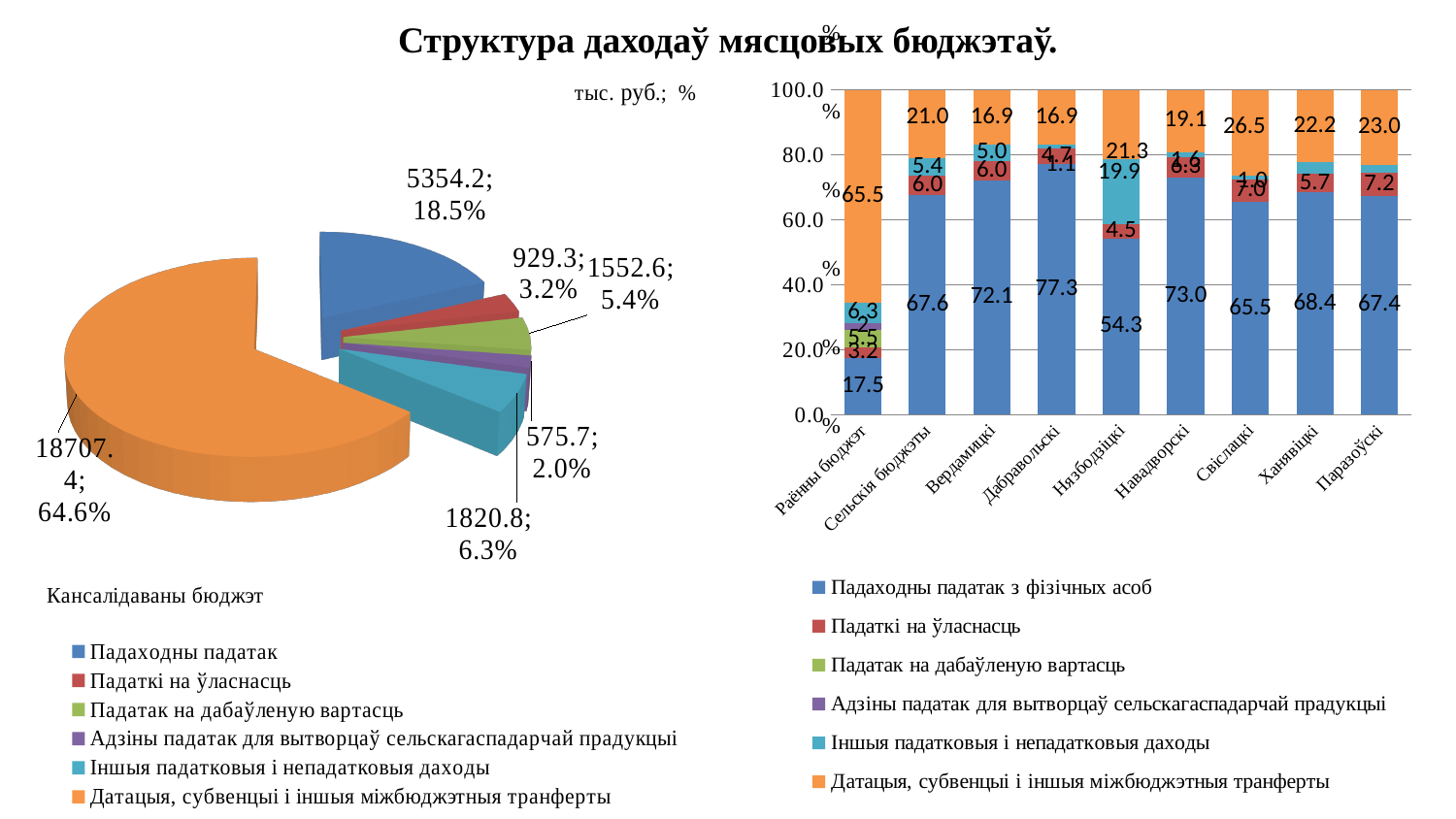
On the pie chart (left), what share does the slice labelled 1552.6 have? 5.4% On the pie chart (left), which slice is the smallest? Адзіны падатак для вытворцаў сельскагаспадарчай прадукцыі (575.7; 2.0%) What kind of chart is the chart on the left of the slide? Pie chart On the pie chart (left), how many entries does the legend list? 6 On the pie chart (left), what value is shown for the orange slice, Датацыі, субвенцыі і іншыя міжбюджэтныя трансферты? 18707.4; 64.6% On the stacked bar chart (right), how many categories are shown on the x axis? 9 On the stacked bar chart (right), what is the value of the orange segment (Датацыі, субвенцыі і іншыя міжбюджэтныя трансферты) for Раённы бюджэт? 65.5 On the stacked bar chart (right), what is the difference between the blue segment values for Дабравольскі and Нязбодзіцкі? 23.0 On the stacked bar chart (right), what is the value of the blue segment (Падаходны падатак з фізічных асоб) for Дабравольскі? 77.3 On the pie chart (left), what value is shown for the blue slice, Падаходны падатак? 5354.2; 18.5% On the stacked bar chart (right), which category has the lowest value for the blue segment (Падаходны падатак з фізічных асоб)? Раённы бюджэт On the stacked bar chart (right), is the orange segment value for Свіслацкі larger or smaller than that for Ханявіцкі? Larger